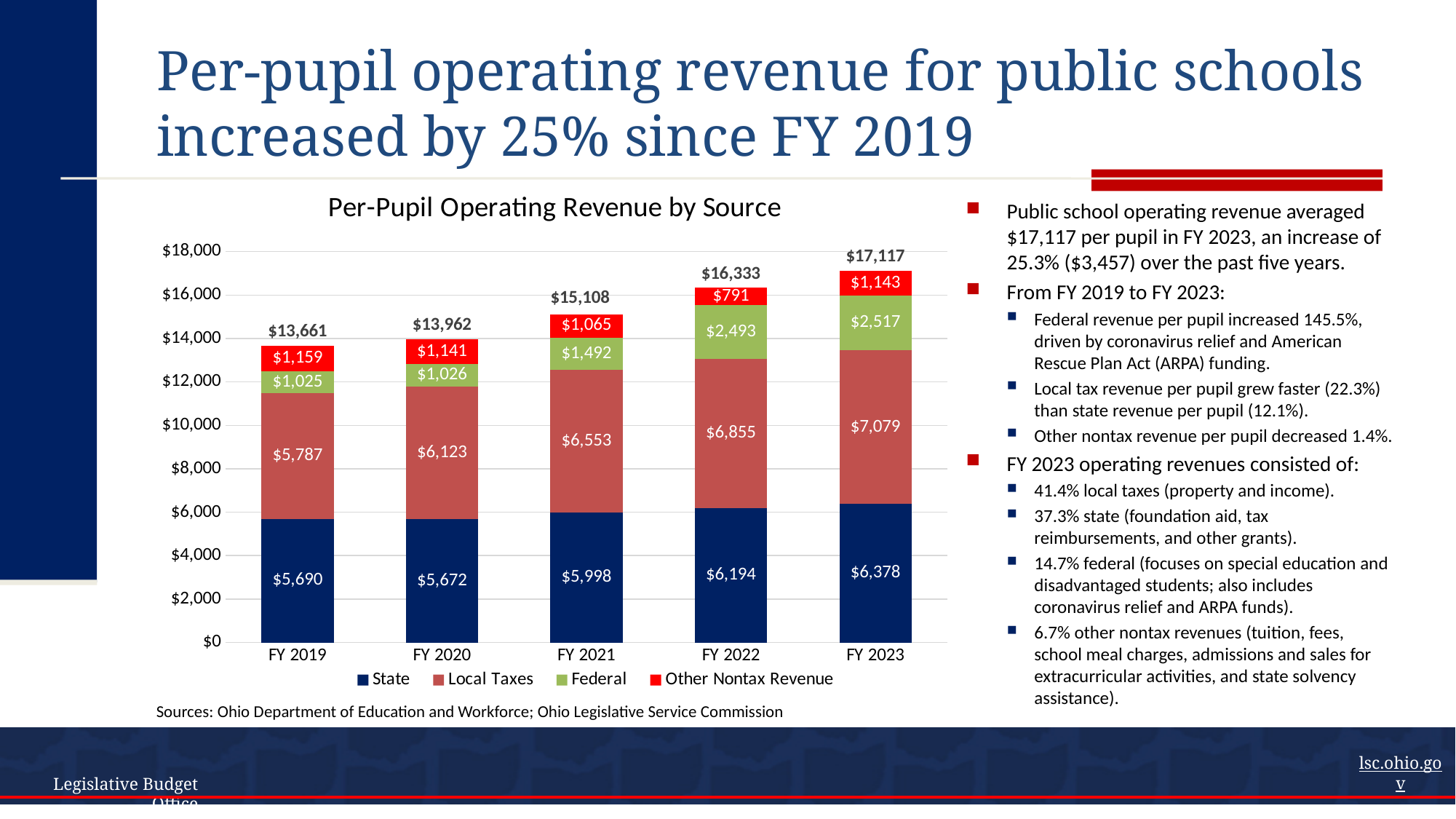
What is the difference between the Local Taxes value in FY 2023 and in FY 2019? $1,292 What is the total per-pupil operating revenue for FY 2022? $16,333 How many series does the legend list? 4 What is the Local Taxes value for FY 2020? $6,123 What kind of chart is shown on the slide? Stacked bar chart Which fiscal year has the lowest Other Nontax Revenue per pupil? FY 2022 How many fiscal years are shown on the x axis? 5 What is the Federal revenue per pupil for FY 2022? $2,493 Is the total per-pupil operating revenue for FY 2021 greater or less than $16,000? less Which is larger in FY 2019: the State value or the Local Taxes value? Local Taxes Which fiscal year has the highest total per-pupil operating revenue? FY 2023 What is the State revenue per pupil for FY 2021? $5,998